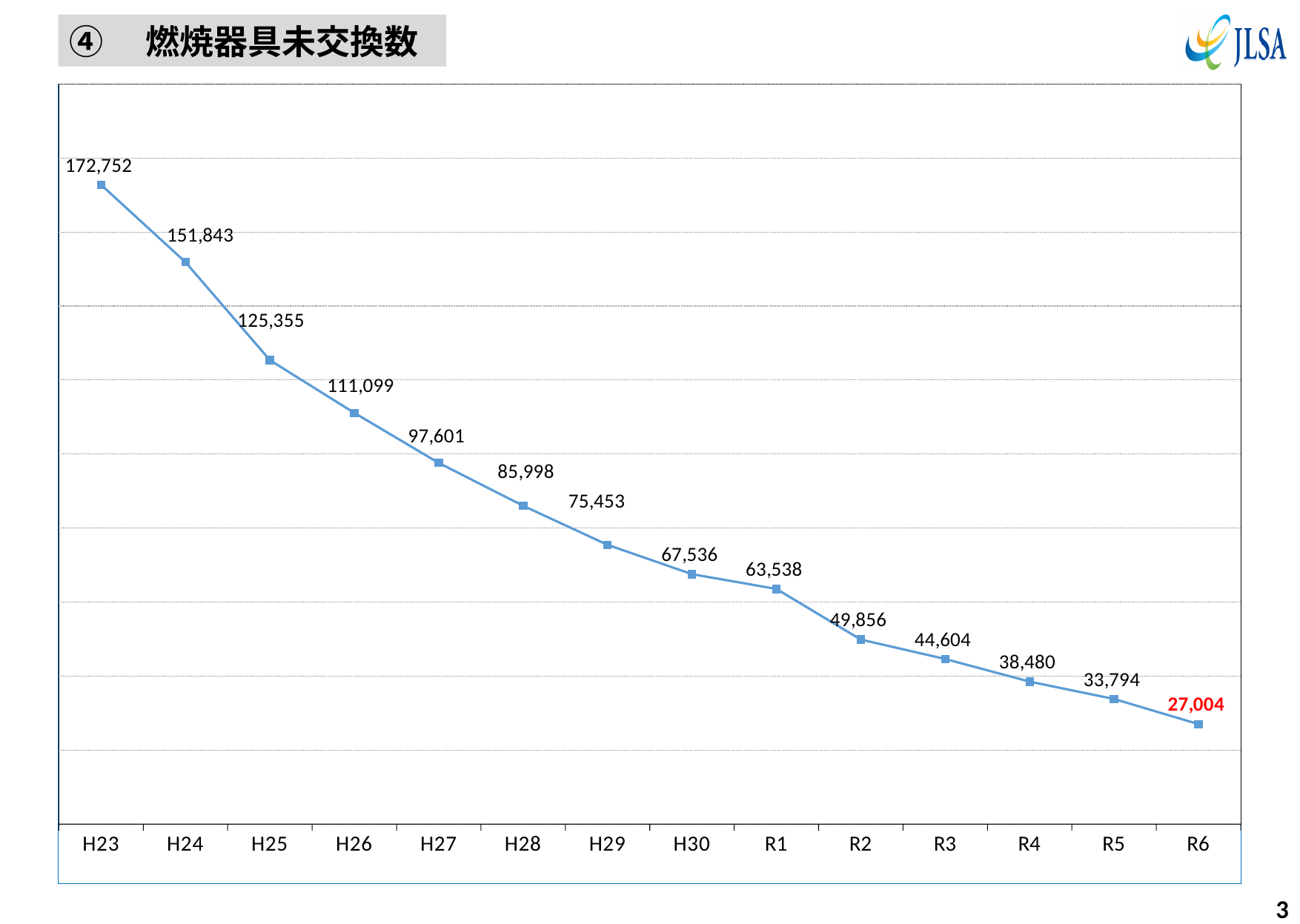
What is the value for H27? 97,601 Which is larger, the value for H30 or the value for R1? H30 Do the values rise or fall from H23 to R6? Fall What is the difference between the values for H23 and H24? 20,909 What is the difference between the values for R5 and R6? 6,790 What kind of chart is shown on the slide? Line chart Which year has the lowest value? R6 How many data points are plotted on the chart? 14 What is the value for R2? 49,856 What is the value for H23? 172,752 Which year has the highest value? H23 What is the value for R6? 27,004